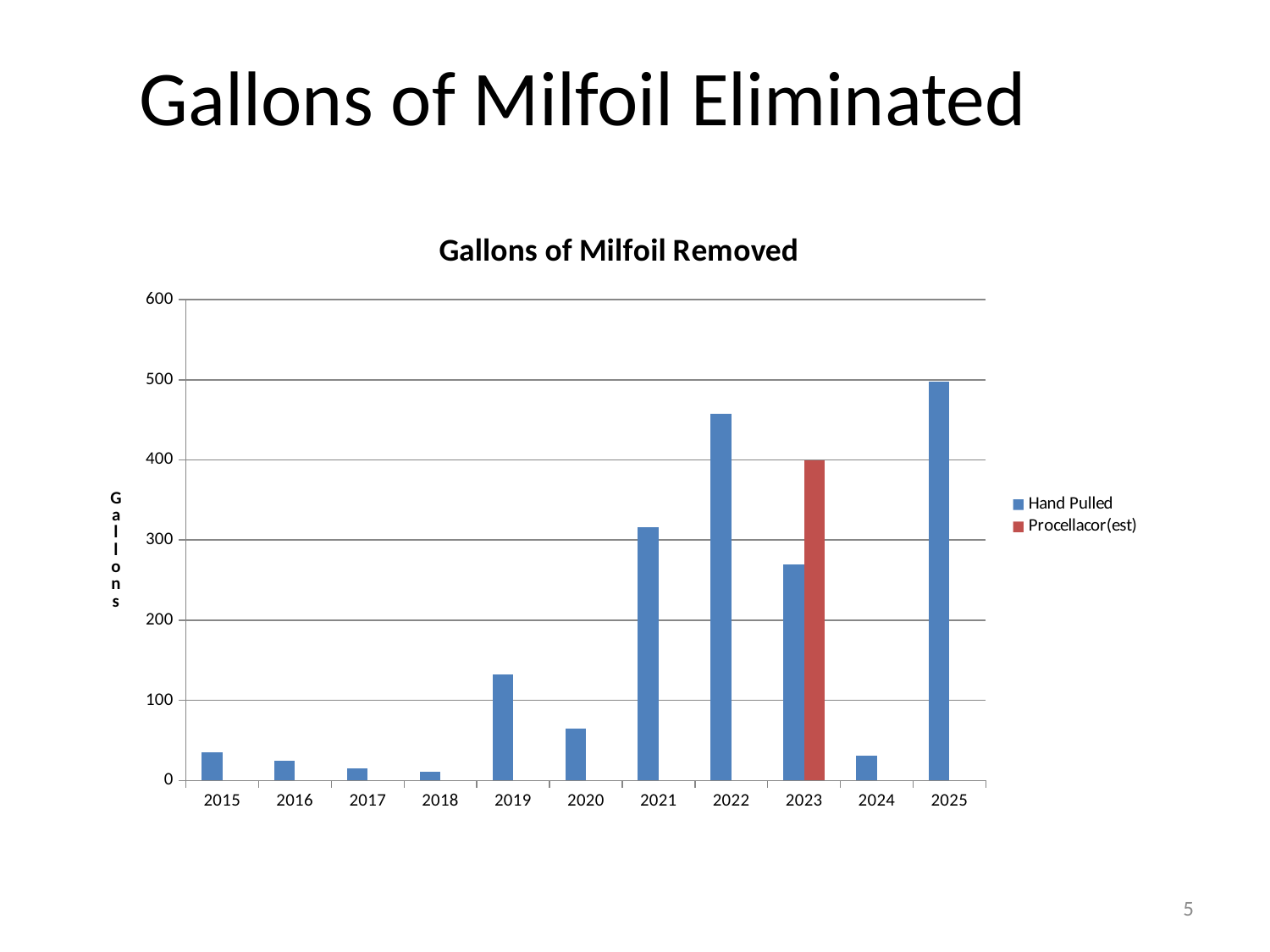
How many years are shown on the x axis? 11 Is the Hand Pulled value for 2021 greater or less than 300? greater Is the Hand Pulled value for 2023 greater or less than 300? less Which year has the highest Hand Pulled value? 2025 What kind of chart is shown on the slide? bar chart Is the Hand Pulled value for 2022 greater or less than 400? greater In 2023, which is larger, the Hand Pulled value or the Procellacor(est) value? Procellacor(est) What is the title of the chart? Gallons of Milfoil Removed Which is larger, the Hand Pulled value for 2021 or for 2022? 2022 How many series does the legend list? 2 Do the Hand Pulled values rise or fall from 2015 to 2018? fall